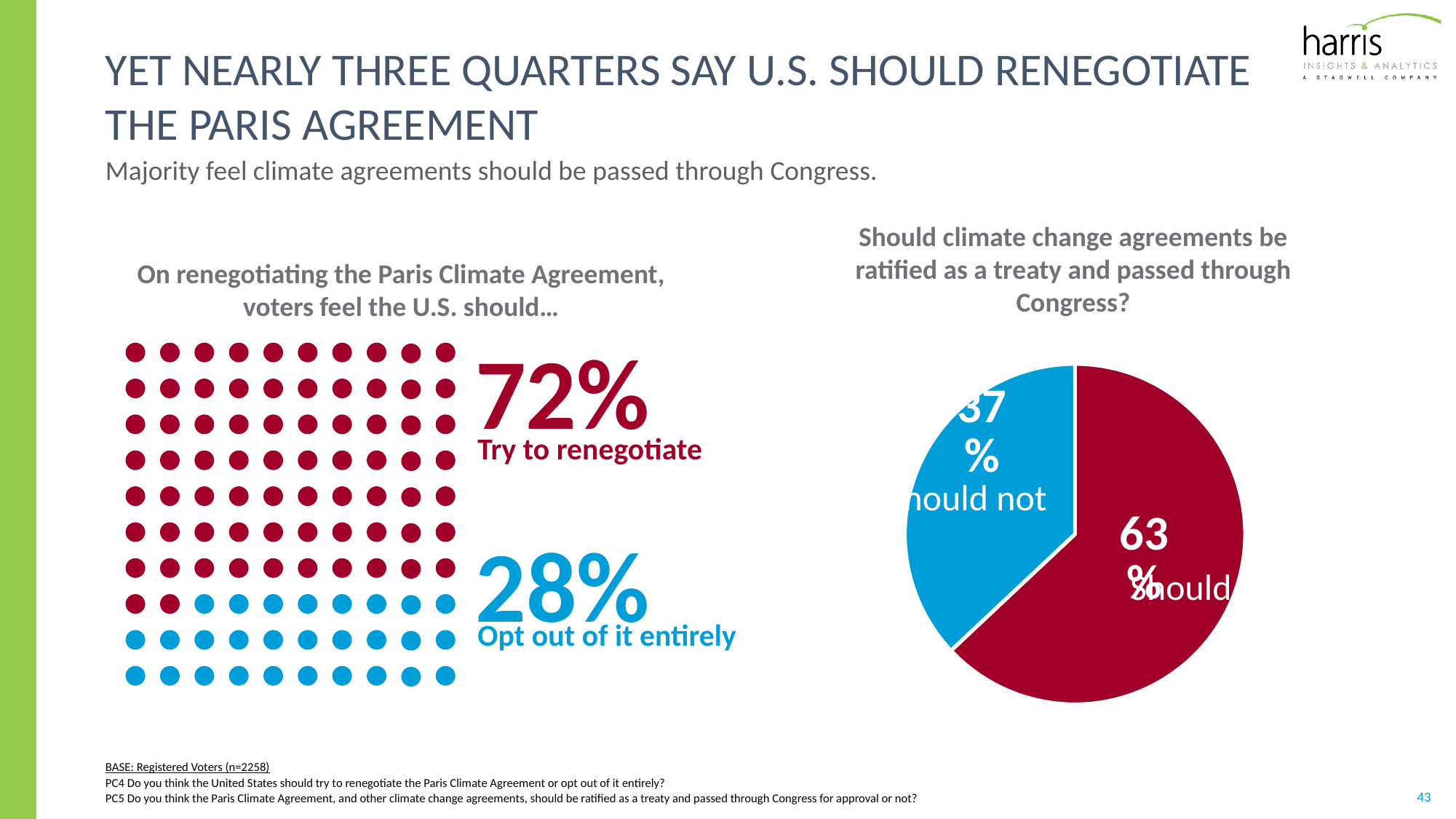
In the chart on the left about renegotiating the Paris Climate Agreement, what percentage of voters say the U.S. should opt out of it entirely? 28% What kind of chart is shown on the right side of the slide? Pie chart In the chart on the left about renegotiating the Paris Climate Agreement, what percentage of voters say the U.S. should try to renegotiate? 72% In the pie chart titled "Should climate change agreements be ratified as a treaty and passed through Congress?", what percentage say "Should"? 63% In the chart on the left, which option has the higher share, "Try to renegotiate" or "Opt out of it entirely"? Try to renegotiate In the chart on the left, what colour are the dots representing "Try to renegotiate"? Red In the pie chart on the right, which slice is larger, "Should" or "Should not"? Should In the pie chart on the right, what is the difference in percentage points between "Should" and "Should not"? 26 In the pie chart on the right, what colour is the "Should not" slice? Blue In the pie chart on the right, what percentage say "Should not"? 37% In the chart on the left, what is the difference in percentage points between "Try to renegotiate" and "Opt out of it entirely"? 44 How many slices does the pie chart on the right have? 2